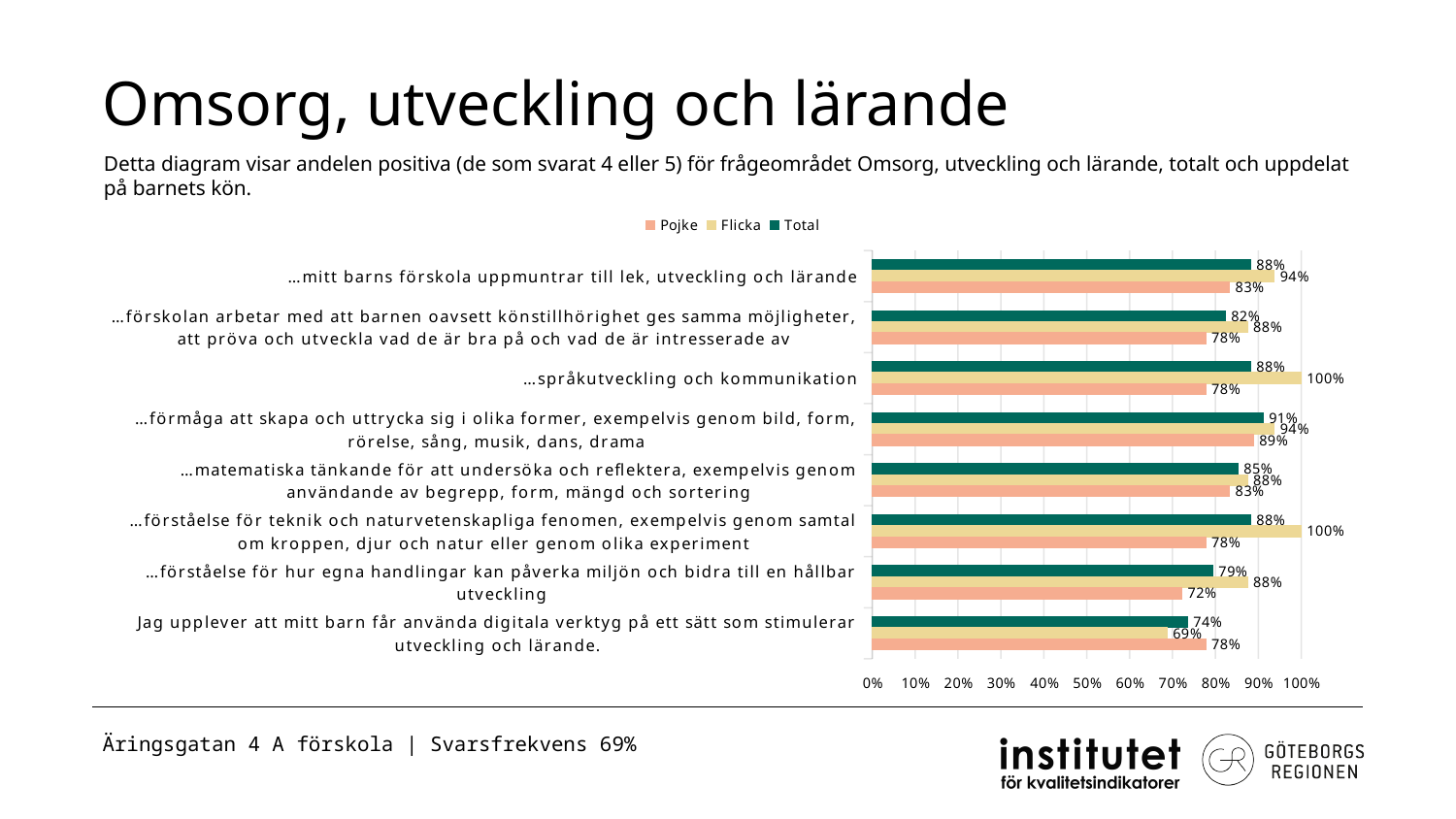
How many series does the legend list? 3 What is the Flicka value for "…förståelse för teknik och naturvetenskapliga fenomen, exempelvis genom samtal om kroppen, djur och natur eller genom olika experiment"? 100% Which series is shown in green in the legend? Total What is the Flicka value for "…matematiska tänkande för att undersöka och reflektera, exempelvis genom användande av begrepp, form, mängd och sortering"? 88% What is the Total value for "…språkutveckling och kommunikation"? 88% What is the Pojke value for "…förståelse för hur egna handlingar kan påverka miljön och bidra till en hållbar utveckling"? 72% For "Jag upplever att mitt barn får använda digitala verktyg på ett sätt som stimulerar utveckling och lärande.", which is larger, the Pojke value or the Flicka value? Pojke Which category has the lowest Total value? Jag upplever att mitt barn får använda digitala verktyg på ett sätt som stimulerar utveckling och lärande. How many categories (statements) are shown in the chart? 8 Which category has the highest Total value? …förmåga att skapa och uttrycka sig i olika former, exempelvis genom bild, form, rörelse, sång, musik, dans, drama What type of chart is shown on the slide? bar chart What is the difference between the Flicka and Pojke values for "…mitt barns förskola uppmuntrar till lek, utveckling och lärande"? 11%